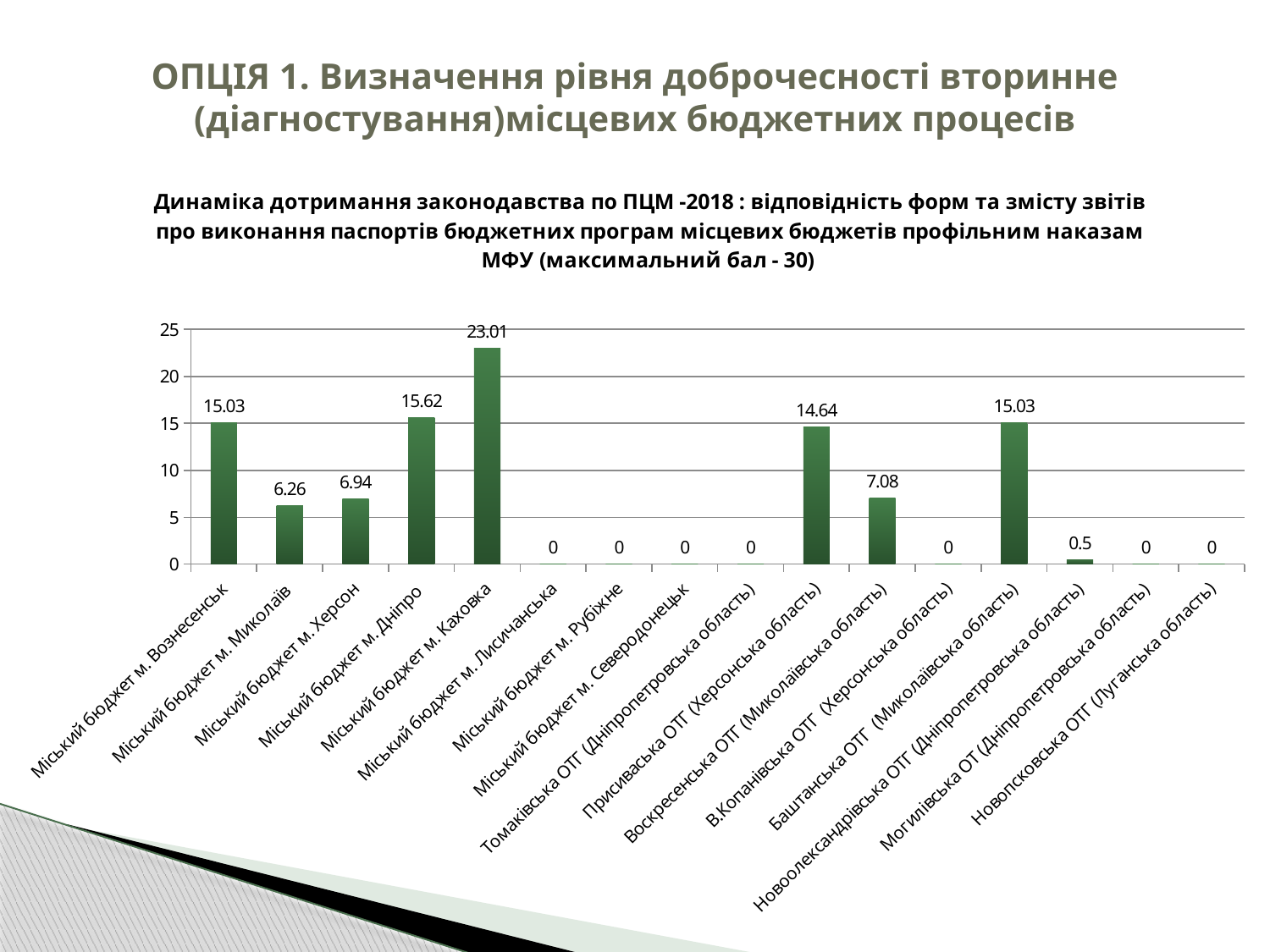
Which category has the highest value? Міський бюджет м. Каховка What is the difference between the values for Міський бюджет м. Дніпро and Міський бюджет м. Херсон? 8.68 What is the maximum score mentioned in the chart title? 30 How many categories have a value of 0? 7 Which is larger, the value for Воскресенська ОТГ (Миколаївська область) or the value for Міський бюджет м. Херсон? Воскресенська ОТГ (Миколаївська область) What kind of chart is shown on the slide? bar chart What is the value for Новоолександрівська ОТГ (Дніпропетровська область)? 0.5 How many categories are shown on the x axis? 16 Is the value for Міський бюджет м. Каховка greater or less than 20? greater What is the value for Міський бюджет м. Миколаїв? 6.26 What is the value for Присиваська ОТГ (Херсонська область)? 14.64 What is the value for Міський бюджет м. Каховка? 23.01